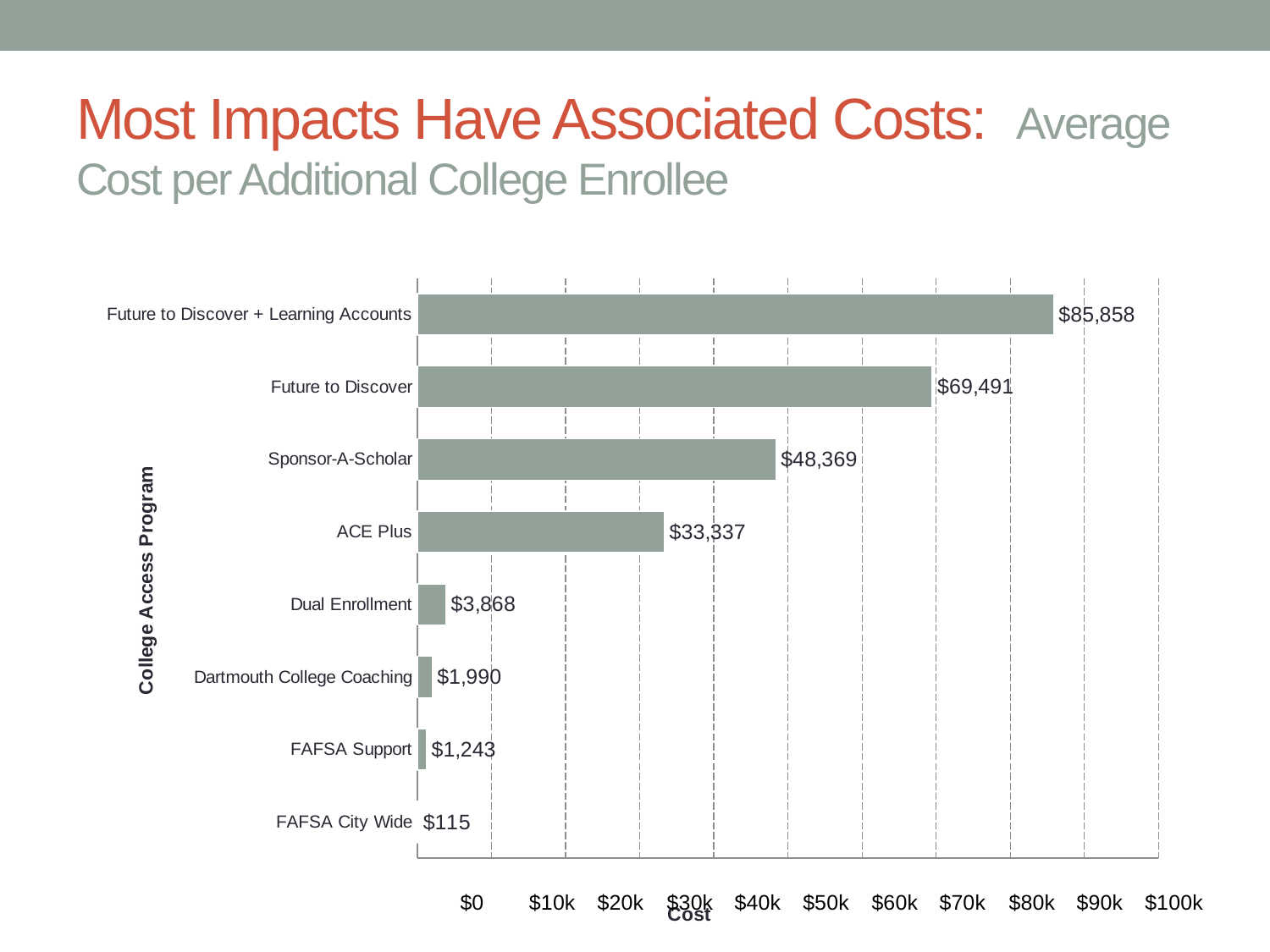
What kind of chart is shown on the slide? Bar chart What is the difference in cost between Dartmouth College Coaching and FAFSA Support? $747 What is the label of the horizontal axis? Cost Which has a higher cost per additional college enrollee, ACE Plus or Sponsor-A-Scholar? Sponsor-A-Scholar What is the value shown for FAFSA City Wide? $115 What is the value shown for Dual Enrollment? $3,868 Is the value for Future to Discover greater or less than $60k? greater What is the average cost per additional college enrollee for Sponsor-A-Scholar? $48,369 What is the difference in cost between Future to Discover + Learning Accounts and Future to Discover? $16,367 Which college access program has the highest cost per additional college enrollee? Future to Discover + Learning Accounts Which college access program has the lowest cost per additional college enrollee? FAFSA City Wide How many college access programs are shown in the chart? 8